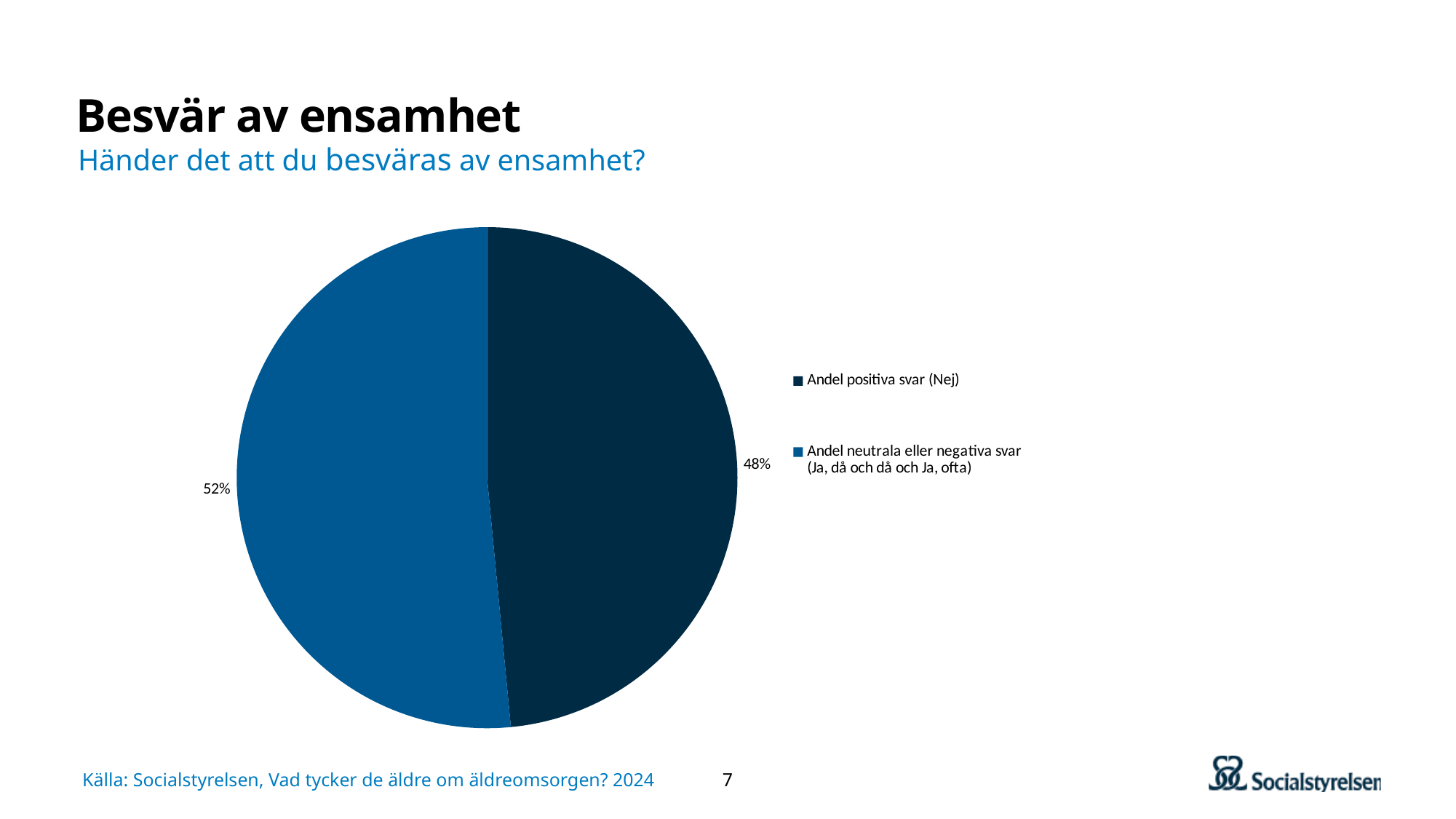
How many entries does the legend list? 2 Which is larger: the share for "Andel positiva svar (Nej)" or the share for "Andel neutrala eller negativa svar"? Andel neutrala eller negativa svar What share of the pie is labelled "Andel positiva svar (Nej)"? 48% What question is shown as the subtitle above the pie chart? Händer det att du besväras av ensamhet? What is the title of the slide containing the pie chart? Besvär av ensamhet What type of chart is shown on the slide? pie chart What share of the pie is labelled "Andel neutrala eller negativa svar (Ja, då och då och Ja, ofta)"? 52% How many slices does the pie chart have? 2 Which slice of the pie is the smallest? Andel positiva svar (Nej) What is the difference in percentage points between the "Andel neutrala eller negativa svar" slice and the "Andel positiva svar (Nej)" slice? 4 percentage points Is the share for "Andel positiva svar (Nej)" greater or less than 50%? less Which slice of the pie is the largest? Andel neutrala eller negativa svar (Ja, då och då och Ja, ofta)